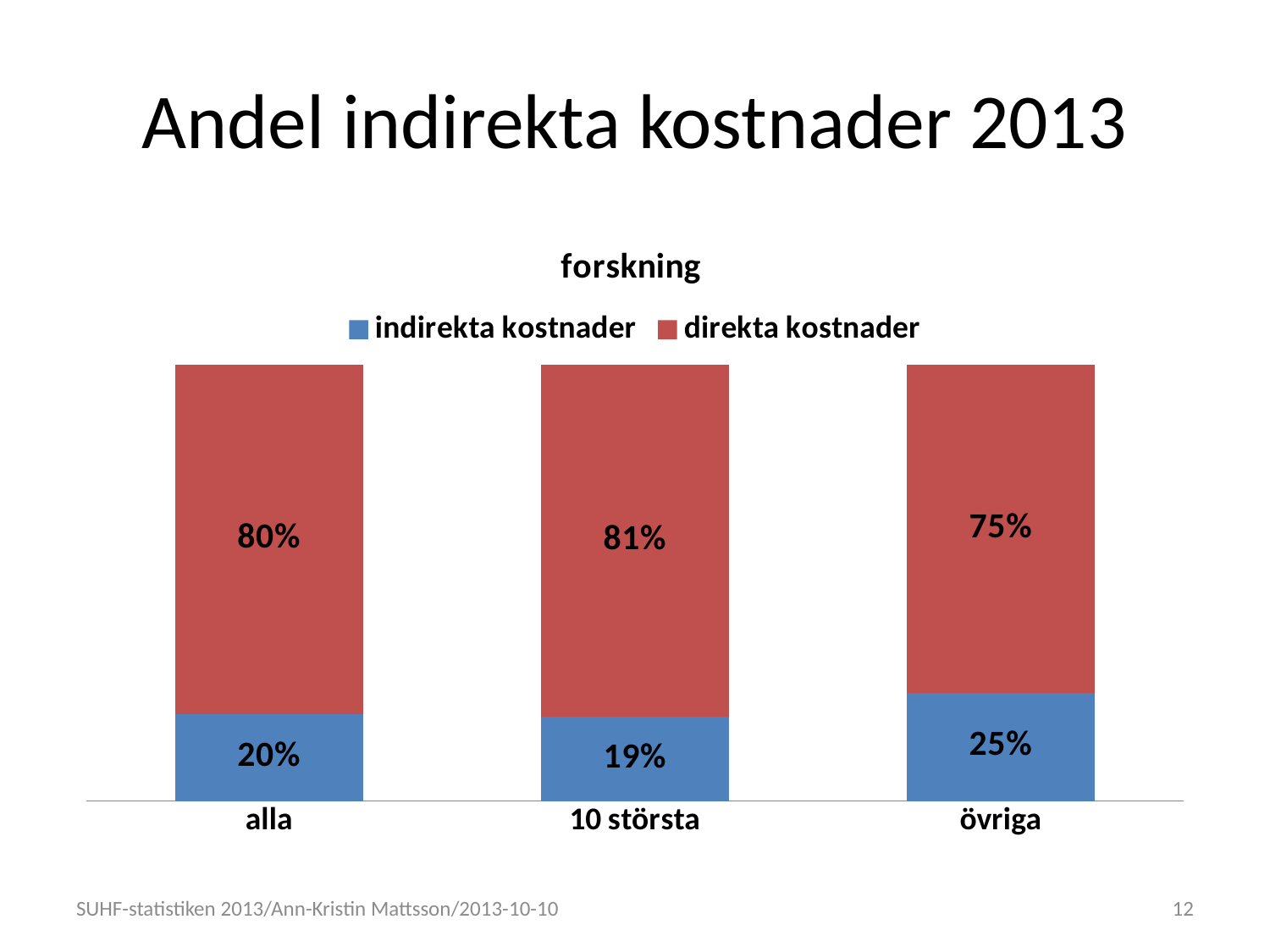
What is the value of indirekta kostnader for övriga? 25% What is the value of indirekta kostnader for alla? 20% Which category has the highest value for indirekta kostnader? övriga How many series does the legend list? 2 Which category has the lowest value for direkta kostnader? övriga How many categories are shown on the x axis? 3 What is the value of direkta kostnader for övriga? 75% What is the value of direkta kostnader for 10 största? 81% Which is larger: direkta kostnader for alla or for 10 största? 10 största What kind of chart is shown on the slide? stacked bar chart What is the title of the chart? forskning What is the difference between indirekta kostnader for övriga and for 10 största? 6%